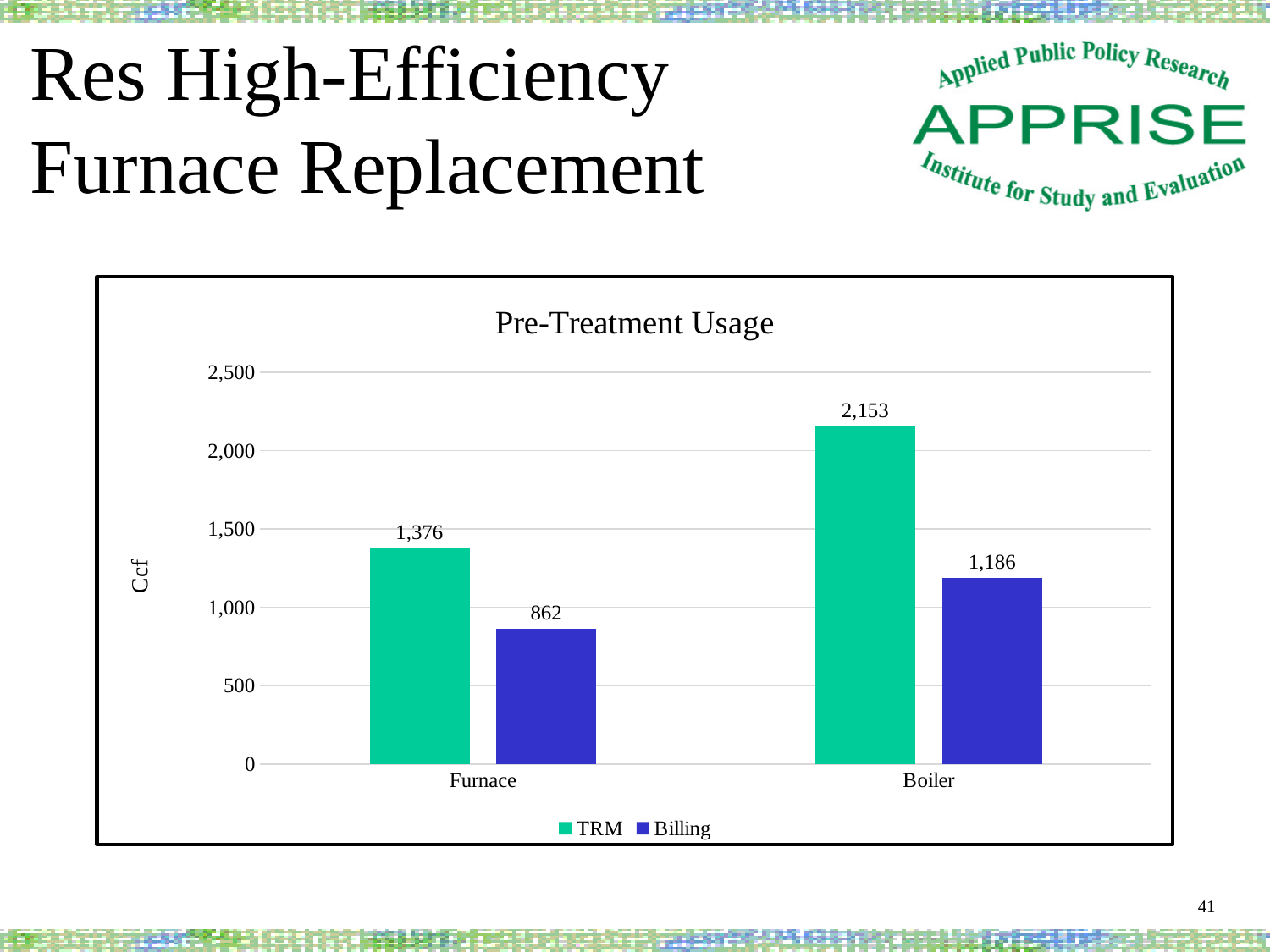
Which bar has the lowest value on the chart? Billing for Furnace What is the title of the chart? Pre-Treatment Usage Which category has the highest TRM value? Boiler What is the difference between the TRM values for Boiler and Furnace? 777 Is the TRM value for Boiler greater or less than 2,000? greater How many series does the legend list? 2 What is the difference between the TRM and Billing values for Boiler? 967 Which is larger, the Billing value for Boiler or the TRM value for Furnace? TRM value for Furnace What is the TRM value for Furnace? 1,376 What is the Billing value for Boiler? 1,186 How many categories are shown on the x axis? 2 What is the Billing value for Furnace? 862